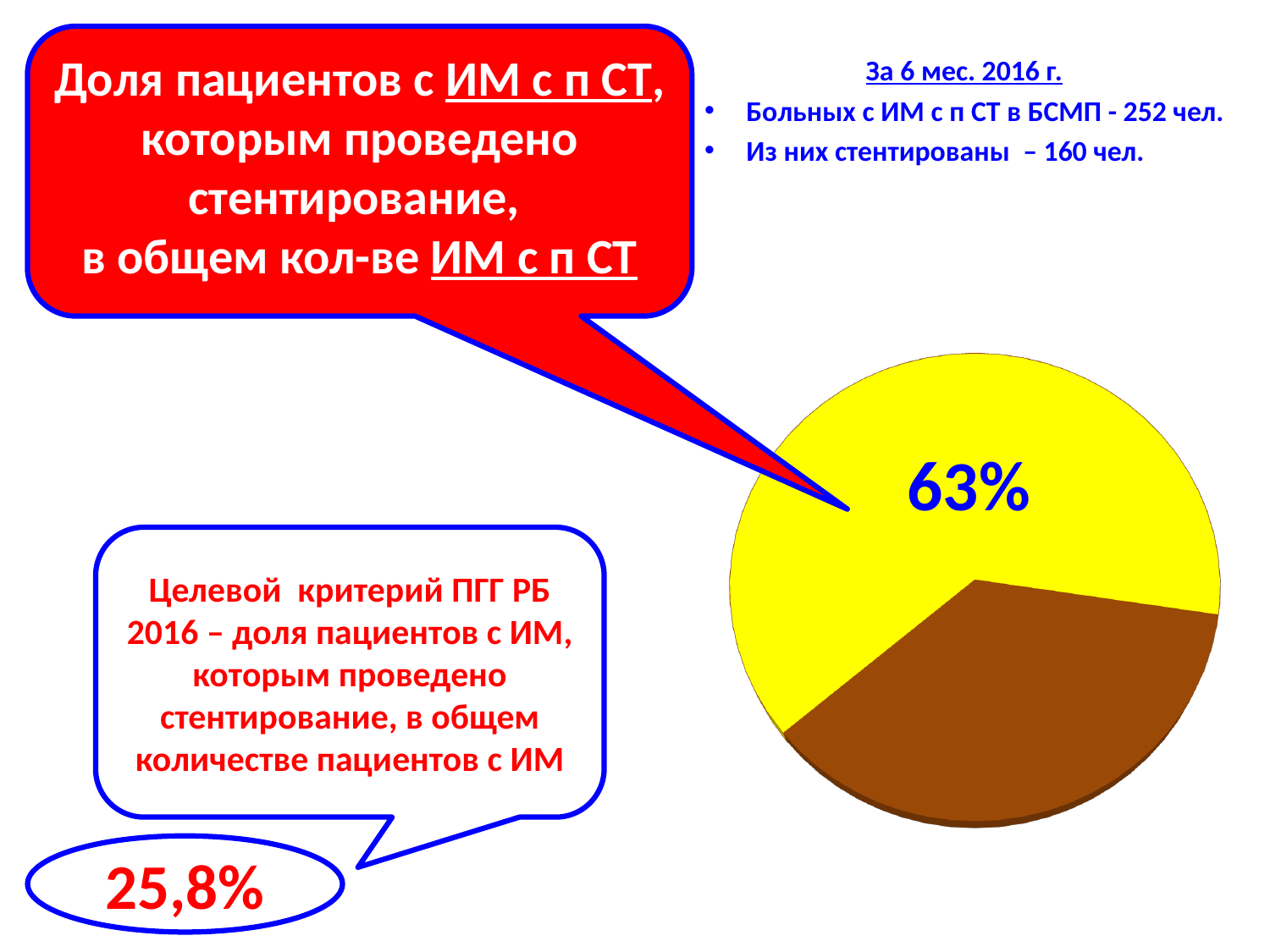
Which slice of the pie chart is larger, the yellow one or the brown one? yellow What share of the pie does the slice labelled with a value represent? 63% Is the share of the brown slice of the pie chart greater or less than 50%? less How many slices does the pie chart have? 2 What colour is the pie slice that carries the 63% label? yellow What percentage is printed on the yellow slice of the pie chart? 63% Does the pie chart have a legend? no What kind of chart is shown on the slide? pie chart Is the share of the yellow slice of the pie chart greater or less than 50%? greater